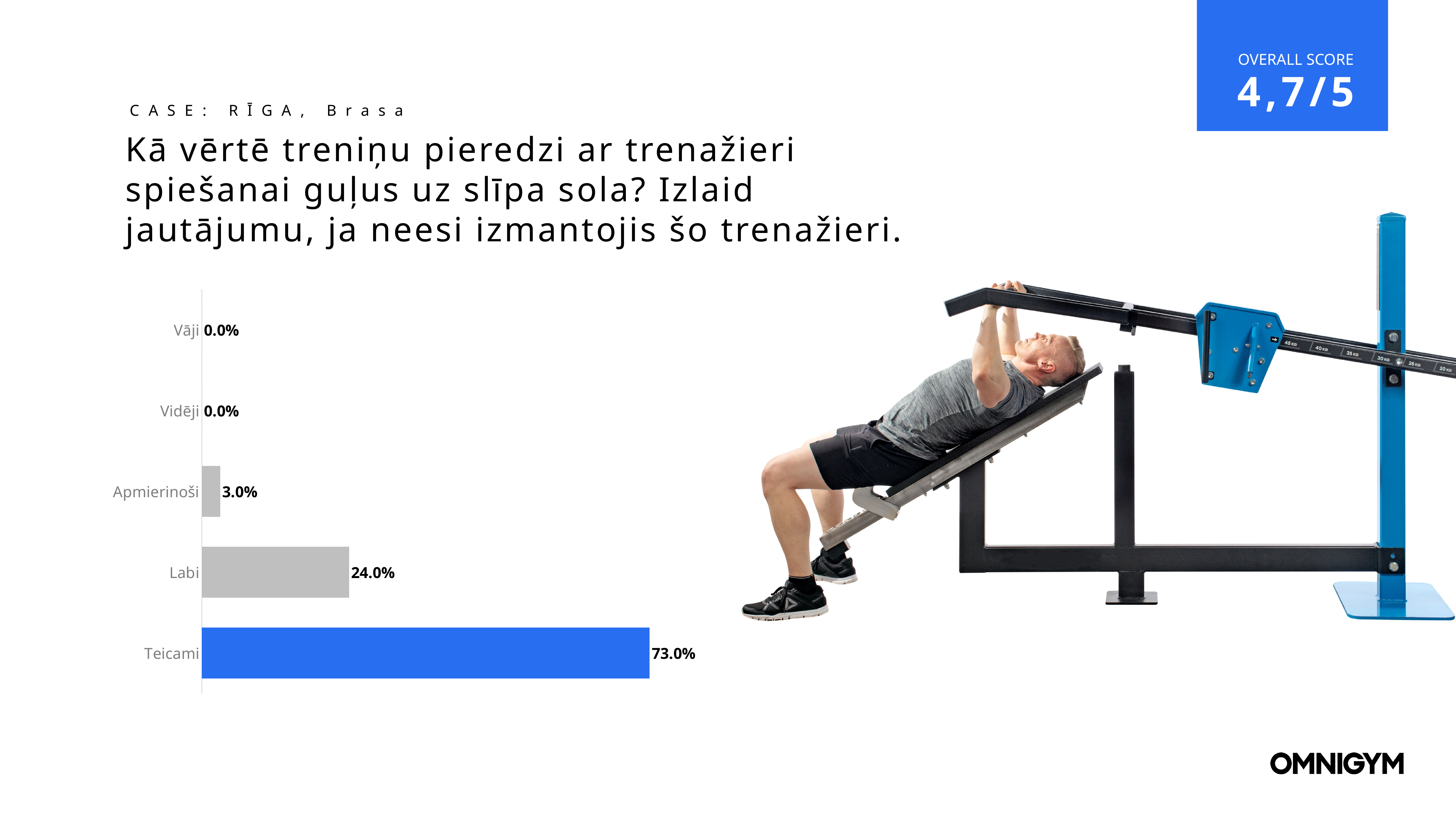
What is the value for Teicami? 73.0% What is the value for Apmierinoši? 3.0% Which is larger, the value for Labi or the value for Apmierinoši? Labi What is the difference between the values for Labi and Apmierinoši? 21.0% Which category has the highest value? Teicami What kind of chart is shown on the slide? bar chart What is the value for Labi? 24.0% What is the difference between the values for Teicami and Labi? 49.0% Which bar in the chart is coloured blue rather than grey? Teicami How many categories have a value of 0.0%? 2 How many categories are shown in the chart? 5 What is the value for Vāji? 0.0%